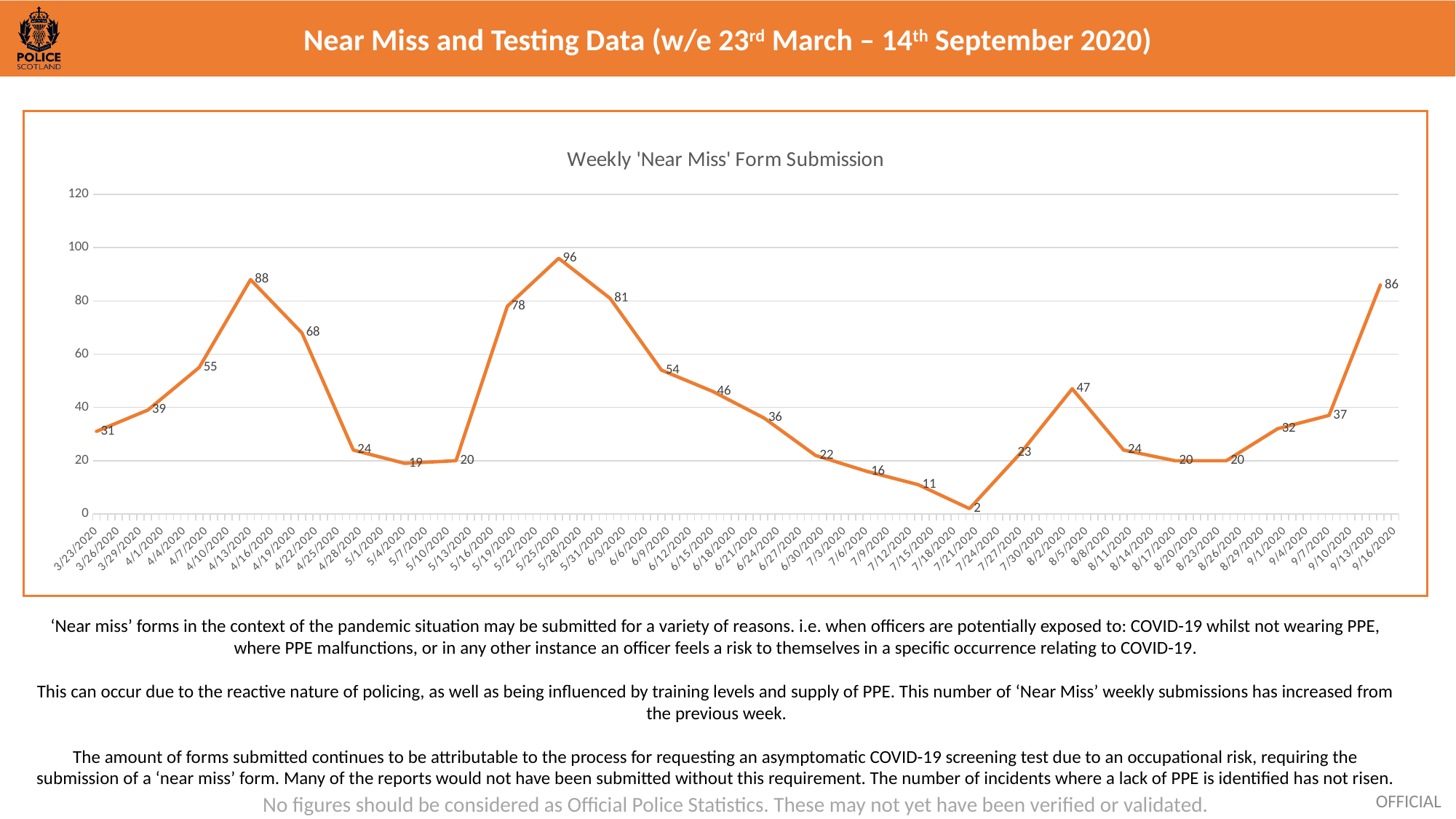
Is the value for 7/6/2020 greater or less than 20? less What is the title of the chart? Weekly 'Near Miss' Form Submission What is the lowest weekly 'Near Miss' form submission value shown on the chart? 2 What is the weekly 'Near Miss' form submission value for 4/13/2020? 88 What is the value of the first data point on the chart (3/23/2020)? 31 What type of chart is shown on the slide? line chart What is the highest weekly 'Near Miss' form submission value shown on the chart? 96 Which is larger: the value for 4/13/2020 or the value for 5/25/2020? 5/25/2020 What is the weekly 'Near Miss' form submission value for 5/25/2020? 96 How many data points are plotted on the line? 26 What is the value of the last data point on the chart? 86 What is the difference between the peak value of 96 and the earlier peak of 88? 8